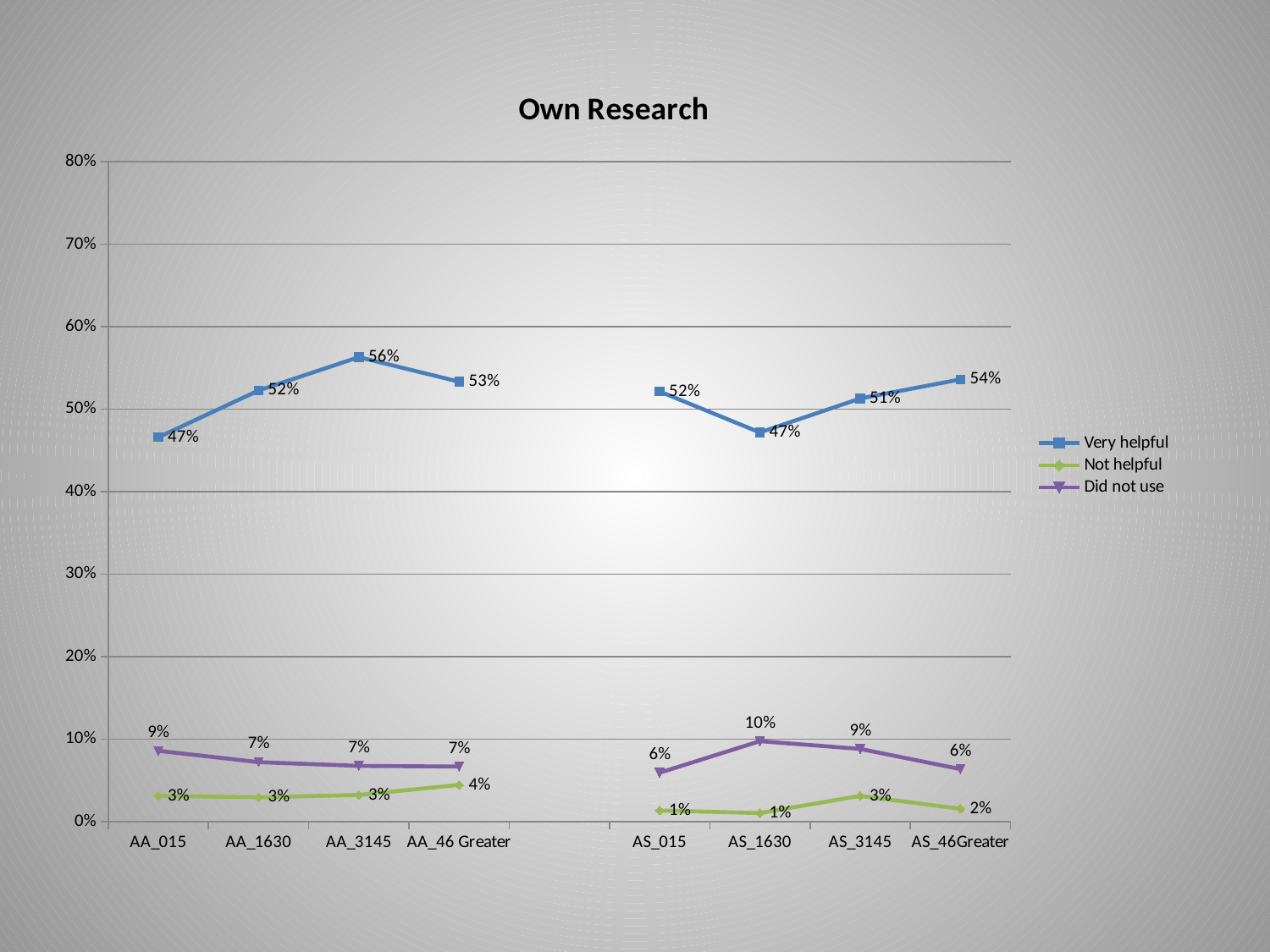
How many series does the legend list? 3 What is the Did not use value for AS_1630? 10% What is the title of the chart? Own Research Which is larger, the Did not use value for AS_1630 or for AS_015? AS_1630 What type of chart is shown on the slide? line chart Which category has the lowest Not helpful value? AS_015 and AS_1630 Which category has the highest Very helpful value? AA_3145 What is the Very helpful value for AA_3145? 56% Is the Very helpful value for AS_1630 greater or less than 50%? less What is the difference between the Very helpful values for AA_3145 and AA_015? 9% How many categories are labeled on the x axis? 8 What is the Not helpful value for AA_46 Greater? 4%